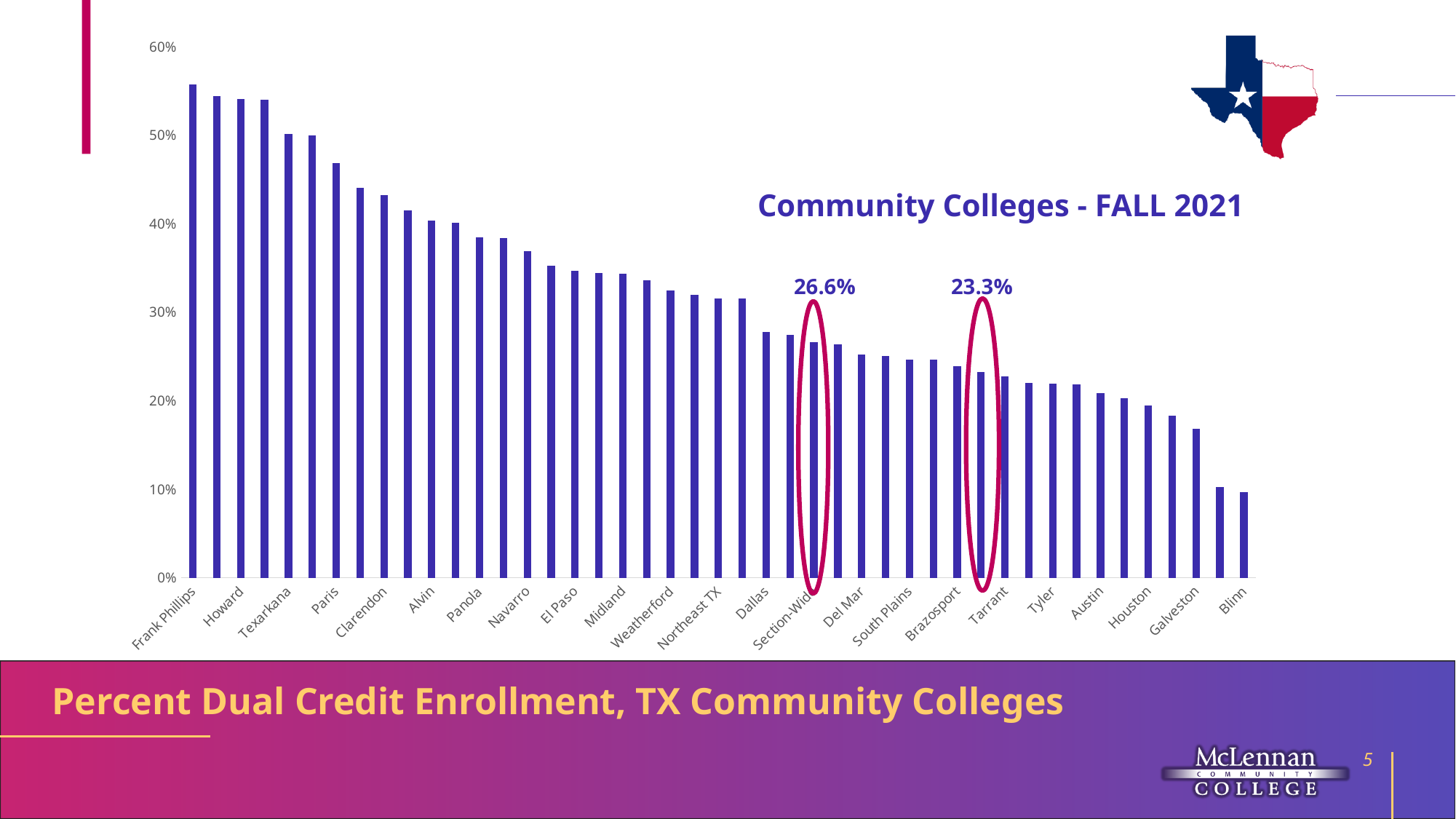
Is the value for Galveston greater or less than 20%? less What kind of chart is shown on the slide? Bar chart Do the values rise or fall moving from left to right along the x axis? Fall What is the value for Section-Wide? 26.6% Which is larger, the value for Howard or the value for Tyler? Howard Which college has the lowest percent dual credit enrollment? Blinn Is the value for Frank Phillips greater or less than 50%? greater Which college has the highest percent dual credit enrollment? Frank Phillips What is the title shown above the chart? Community Colleges - FALL 2021